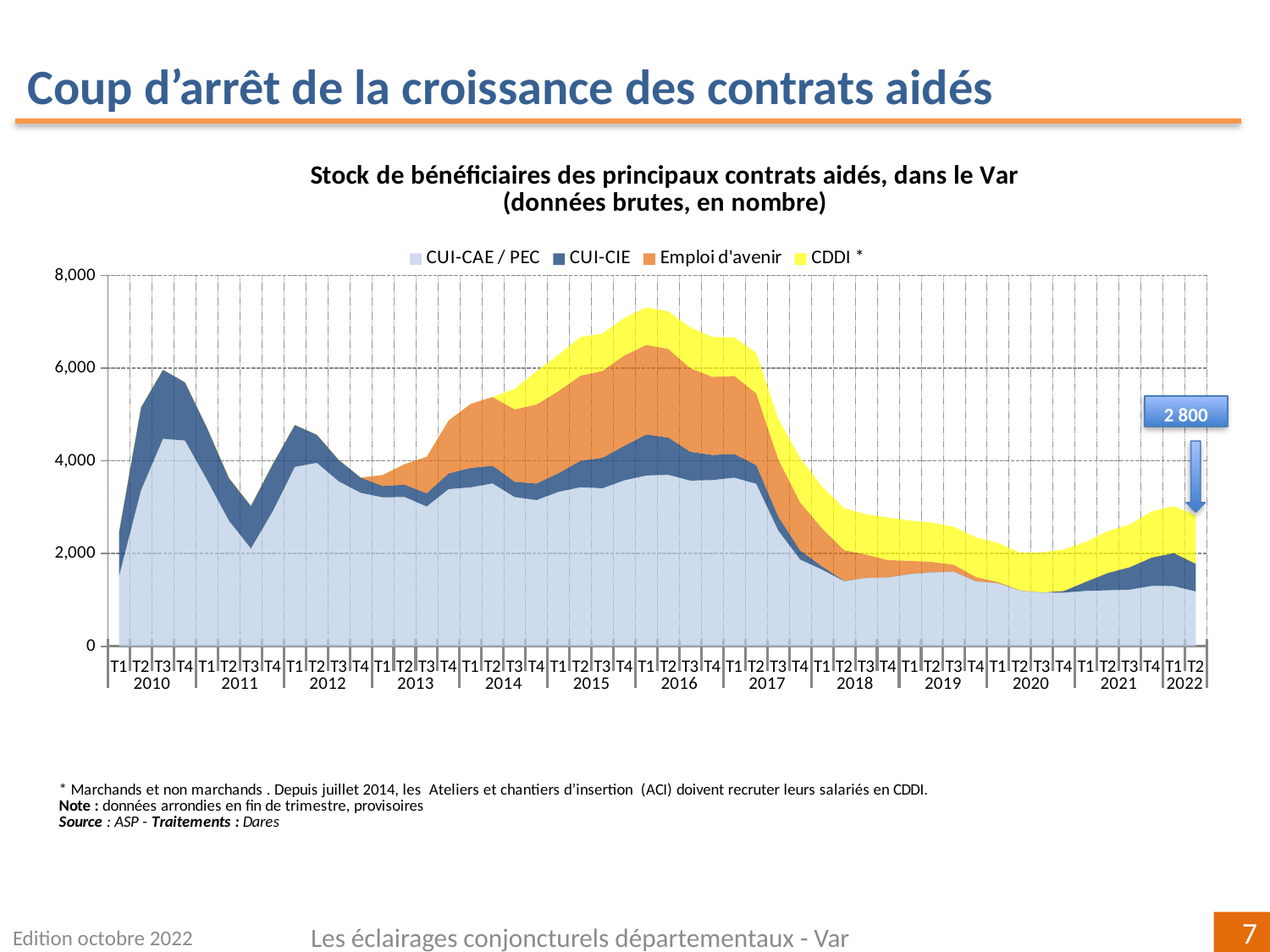
In which year does the total stock of beneficiaries reach its highest level? 2016 What total stock of beneficiaries is annotated for T2 2022? 2 800 Is the total stock of beneficiaries in T4 2021 greater or less than 2,000? greater Which is larger, the CUI-CAE / PEC stock in T3 2010 or in T3 2020? T3 2010 Which series is shown in yellow? CDDI * What kind of chart is shown on the slide? stacked area chart How many series does the chart legend list? 4 Which series is at the bottom of the stacked areas? CUI-CAE / PEC Does the total stock of beneficiaries rise or fall between T1 2016 and T1 2018? fall Which is larger, the total stock of beneficiaries in T1 2016 or in T1 2020? T1 2016 Is the total stock of beneficiaries in T1 2012 greater or less than 4,000? greater Is the total stock of beneficiaries in T1 2016 greater or less than 6,000? greater